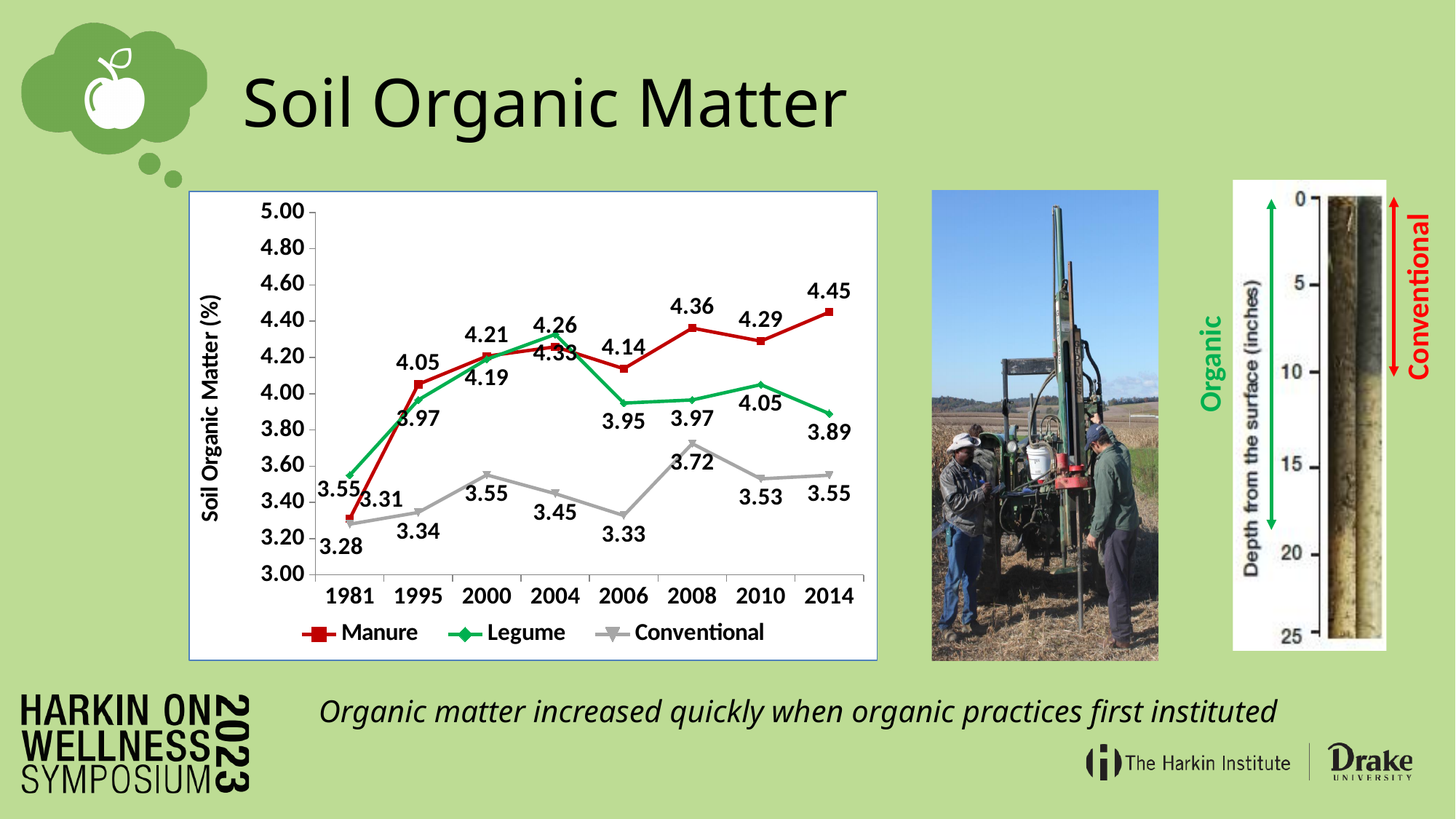
What is the label on the y axis of the chart? Soil Organic Matter (%) What is the Legume value in 2004? 4.33 How many series does the legend list? 3 How many years are shown on the x axis? 8 What is the Soil Organic Matter value for Manure in 2014? 4.45 In which year is the Conventional series at its lowest value? 1981 In 2010, which is larger: the Legume value or the Conventional value? Legume Does the Manure series rise or fall from 1981 to 1995? Rise What is the Conventional value in 2008? 3.72 What is the difference between the Manure and Legume values in 2014? 0.56 What kind of chart is shown on the slide? Line chart In which year does the Manure series reach its highest value? 2014